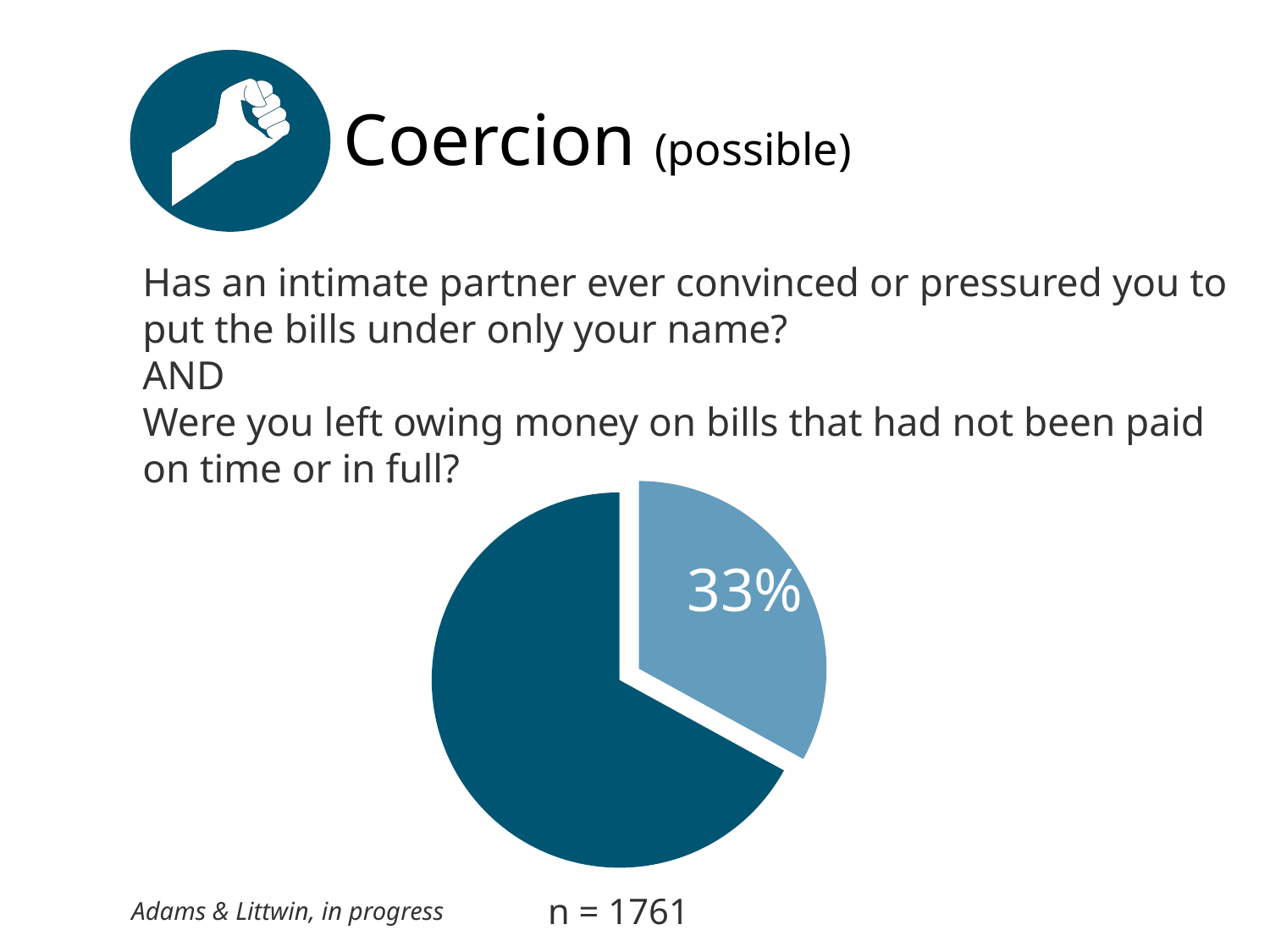
Which slice of the pie chart is larger, the dark blue slice or the light blue slice? the dark blue slice How many slices does the pie chart have? 2 Which slice of the pie chart is the smallest? the light blue slice (33%) Is the light blue slice of the pie chart greater or less than 50% of the pie? less What is the title of the slide containing the pie chart? Coercion (possible) Is the dark blue slice of the pie chart greater or less than 50% of the pie? greater What share of the pie does the exploded (separated) slice represent? 33% What kind of chart is shown on the slide? pie chart What percentage is printed on the light blue slice of the pie chart? 33% What sample size (n) is shown below the pie chart? n = 1761